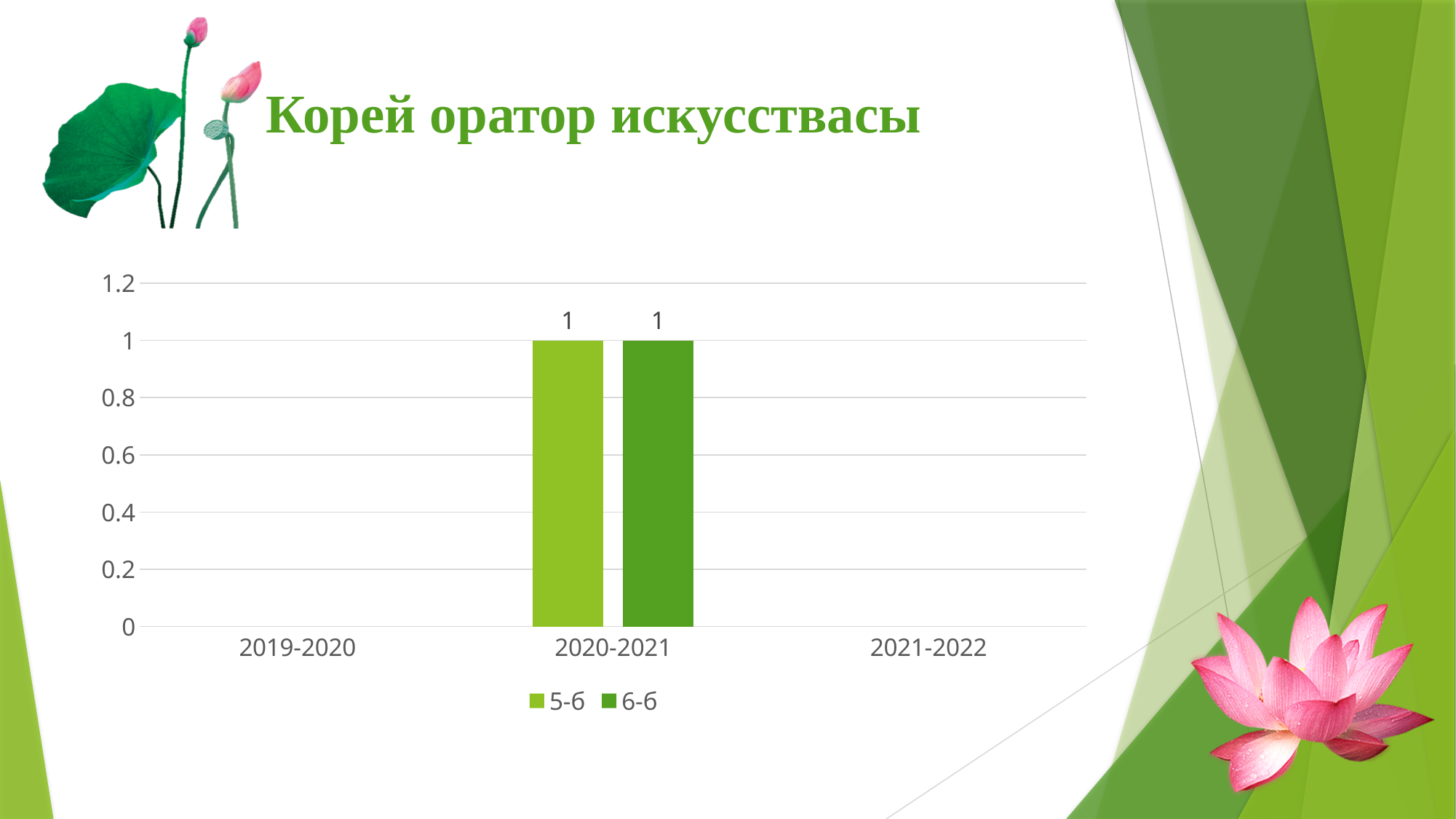
How many series does the legend list? 2 Is the value for 6-б in 2020-2021 greater or less than 1.2? less What are the two series named in the legend? 5-б and 6-б What is the value for 6-б in 2020-2021? 1 Is the value for 5-б in 2020-2021 greater or less than 0.8? greater What is the title of the slide? Корей оратор искусствасы Which category has the highest value for 6-б? 2020-2021 How many categories are shown on the x axis? 3 What is the difference between the 5-б and 6-б values in 2020-2021? 0 What is the value for 5-б in 2020-2021? 1 What kind of chart is shown on the slide? bar chart Which category has the highest value for 5-б? 2020-2021